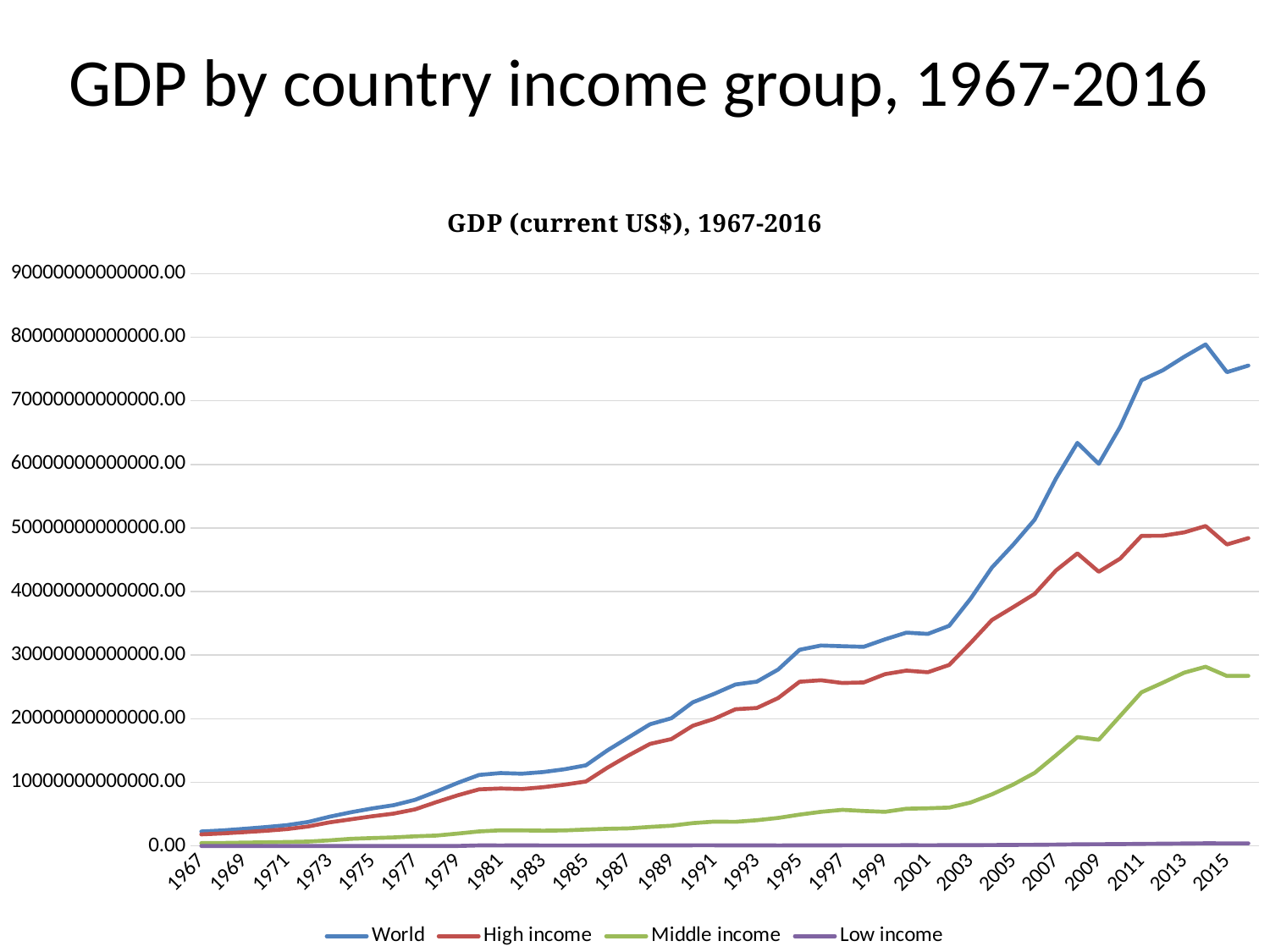
What is the title printed above the chart? GDP (current US$), 1967-2016 What kind of chart is shown on the slide? line chart Is the value for Middle income in 2001 greater or less than 100000000000000.00? less How many series does the legend list? 4 Which colour is used for the World line? blue In 2015, which is larger: Middle income or Low income? Middle income Is the value for World in 2013 greater or less than 700000000000000.00? greater Is the value for Middle income in 2016 greater or less than 200000000000000.00? greater Which series has the highest value in 2016? World Which series has the lowest value across the whole period? Low income Does the World series generally rise or fall from 1967 to 2016? rise